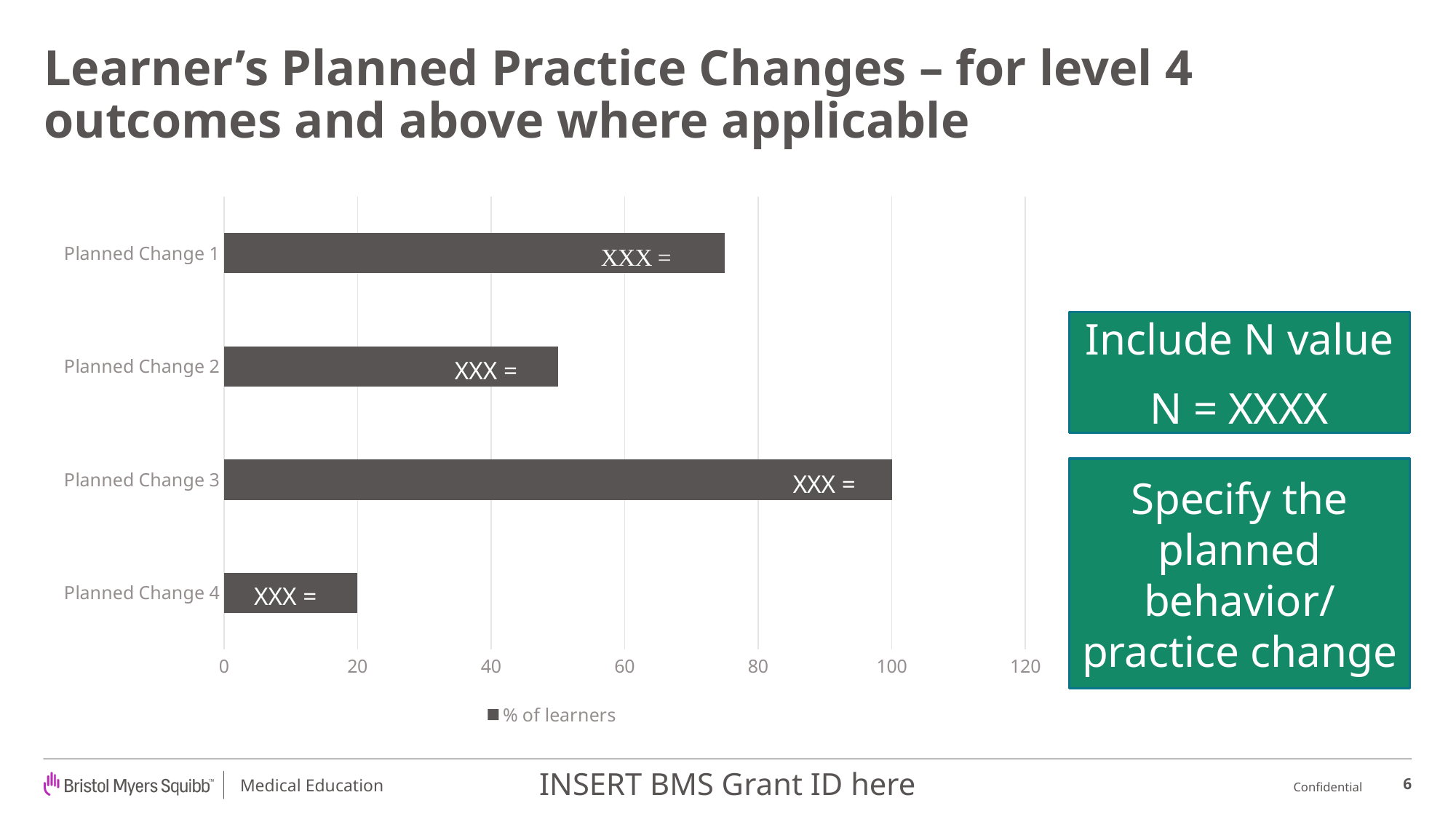
How many categories are plotted in the chart? 4 What is the name of the series shown in the chart legend? % of learners Is the value for Planned Change 2 greater or less than 60? less Which category has the highest value in the chart? Planned Change 3 What kind of chart is shown on the slide? bar chart Which is larger, the value for Planned Change 1 or the value for Planned Change 2? Planned Change 1 Is the value for Planned Change 1 greater or less than 60? greater Which category has the lowest value in the chart? Planned Change 4 What is the difference between the values for Planned Change 3 and Planned Change 4? 80 How many series does the chart legend list? 1 What is the value for Planned Change 3? 100 What is the value for Planned Change 4? 20